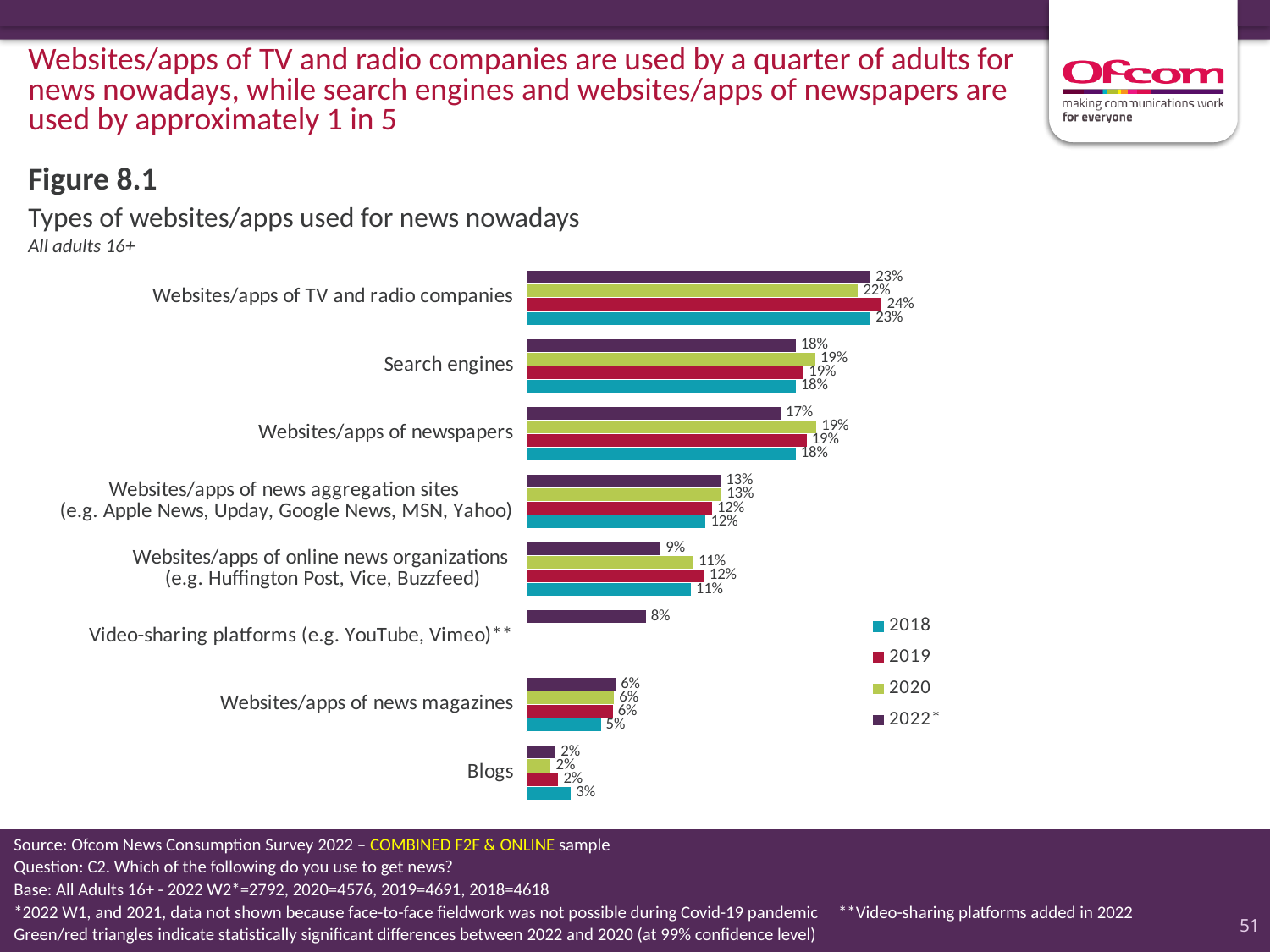
What is the 2022* value for Video-sharing platforms (e.g. YouTube, Vimeo)? 8% How many categories are shown on the chart? 8 Which series is shown in purple in the legend? 2022* What is the difference between the 2020 and 2022* values for Websites/apps of newspapers? 2% What is the 2022* value for Websites/apps of TV and radio companies? 23% Which category has the highest 2022* value? Websites/apps of TV and radio companies What is the 2018 value for Blogs? 3% Which is larger for Websites/apps of online news organizations: the 2019 value or the 2022* value? 2019 Which category has the lowest 2022* value? Blogs What is the 2019 value for Websites/apps of TV and radio companies? 24% What kind of chart is shown on the slide? Bar chart How many series does the legend list? 4